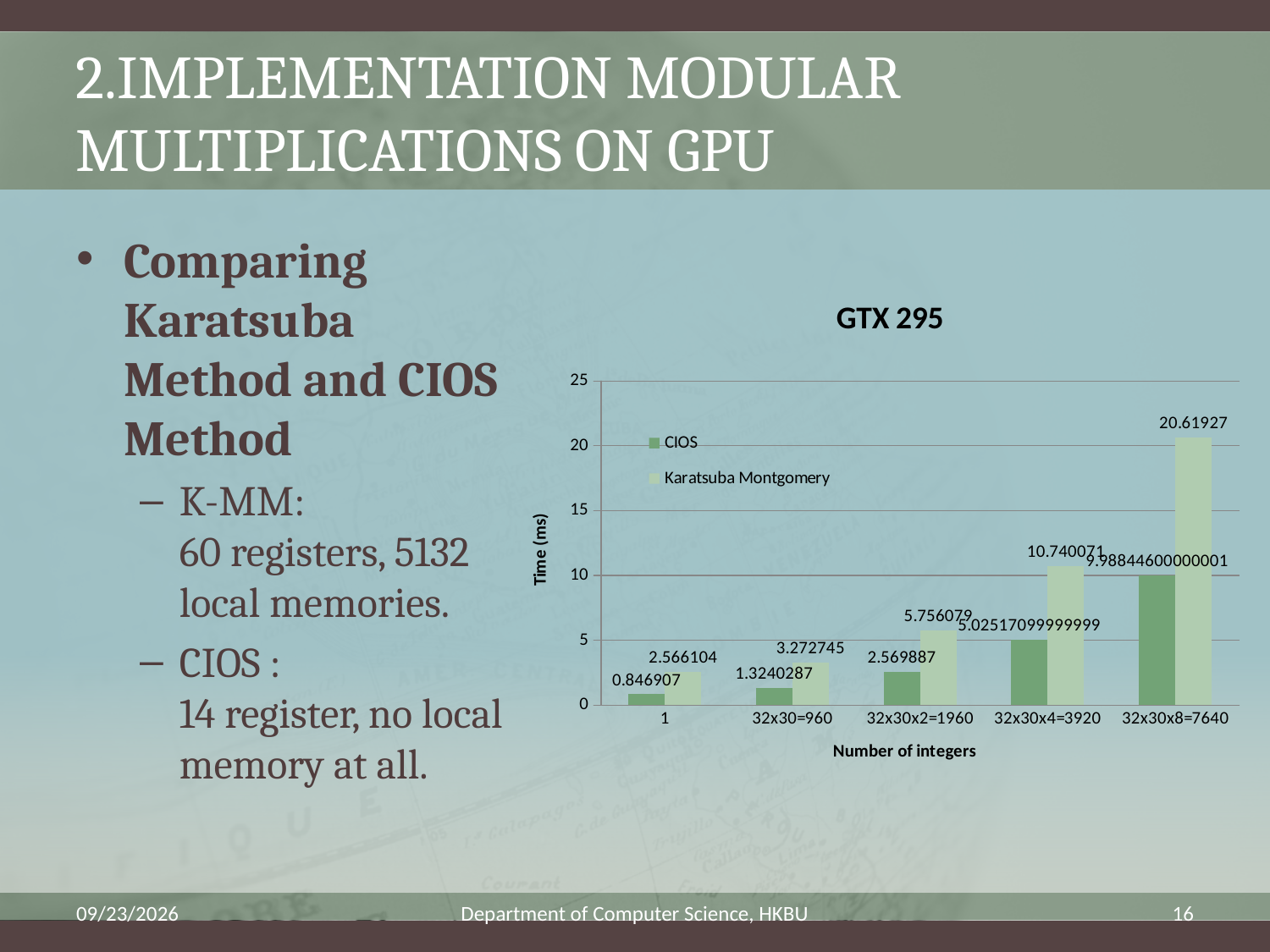
What is the CIOS time for 1 integer? 0.846907 What is the Karatsuba Montgomery time for 32x30x8=7640 integers? 20.61927 How many categories are shown on the x axis of the chart? 5 What is the Karatsuba Montgomery time for 32x30x2=1960 integers? 5.756079 What is the title of the chart? GTX 295 What is the CIOS time for 32x30=960 integers? 1.3240287 Which category has the lowest CIOS time? 1 How many series does the chart legend list? 2 What type of chart is shown on the slide? bar chart Do the CIOS times rise or fall as the number of integers increases along the x axis? rise What is the difference between the Karatsuba Montgomery and CIOS times for 1 integer? 1.719197 Which category has the highest Karatsuba Montgomery time? 32x30x8=7640